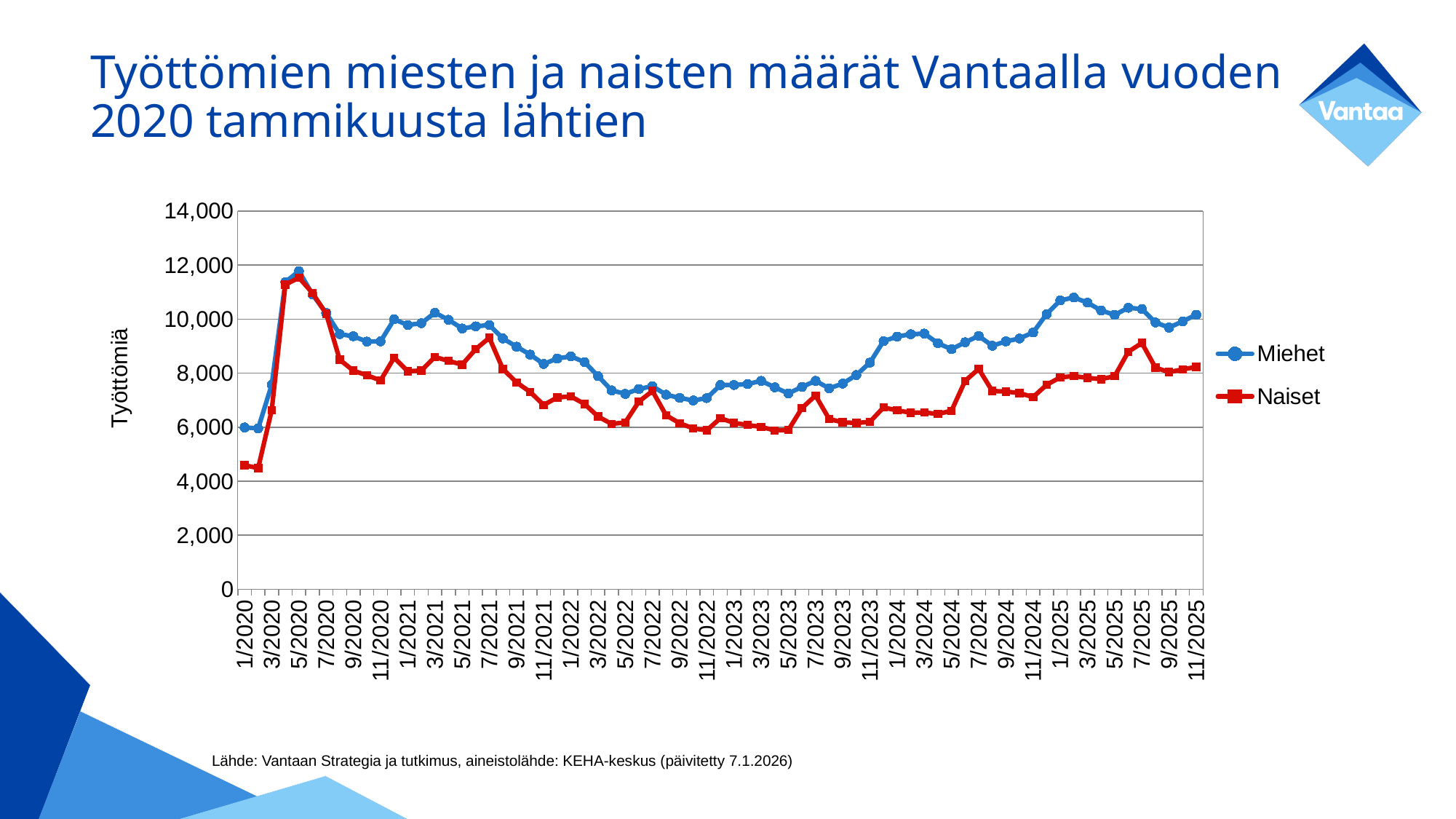
Is the value for Miehet in 9/2022 greater or less than 8,000? less What are the two series named in the legend? Miehet and Naiset Is the value for Naiset in 1/2020 greater or less than 6,000? less Is the value for Naiset in 7/2025 greater or less than 8,000? greater In which month does the Miehet series reach its highest value? 5/2020 What is the label on the vertical axis? Työttömiä What kind of chart is shown on the slide? line chart How many series does the legend list? 2 In which month does the Naiset series reach its highest value? 5/2020 Does the Miehet series rise or fall between 5/2020 and 11/2022? fall Which series has the larger value in 11/2025, Miehet or Naiset? Miehet